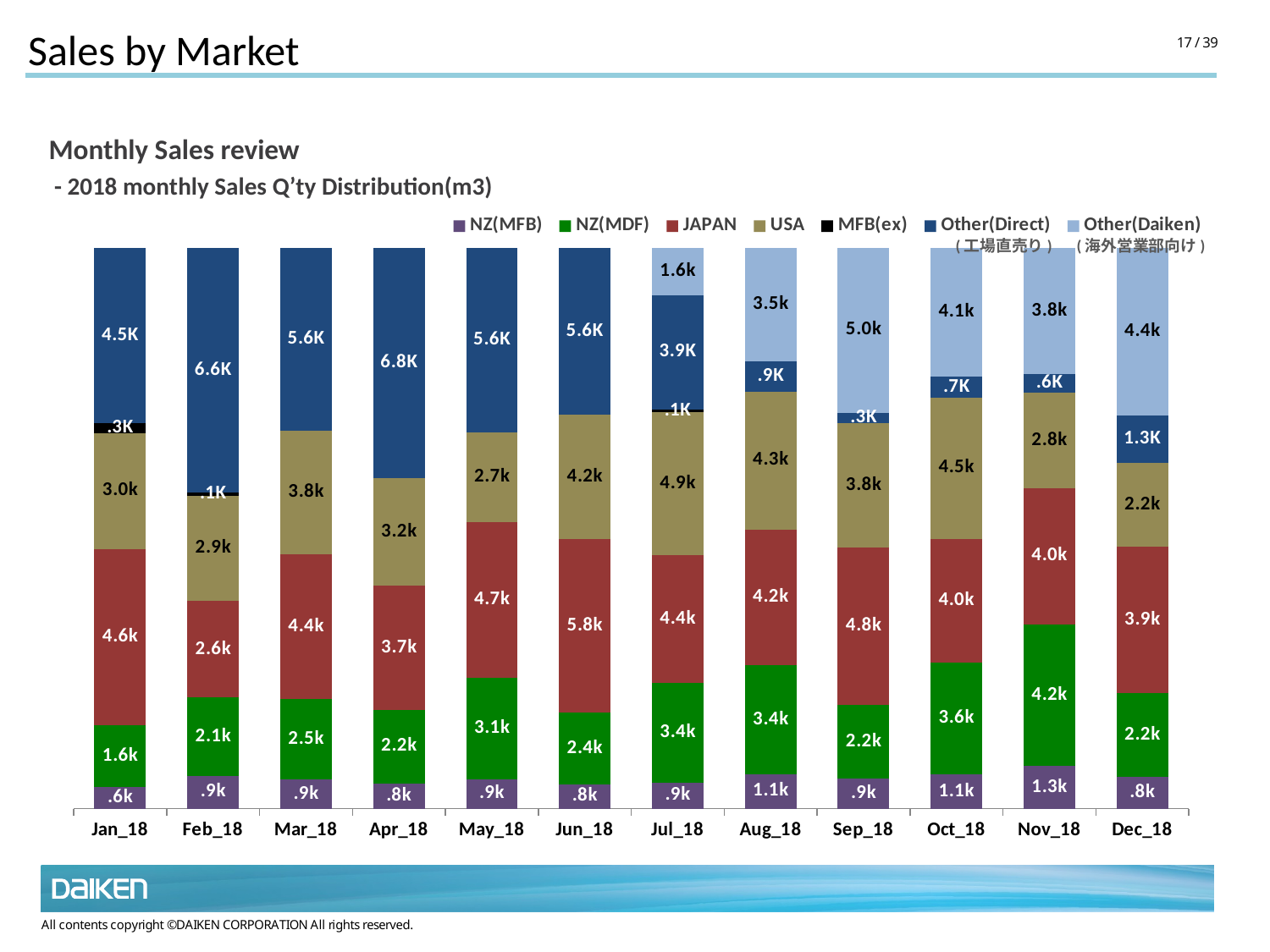
What is the Other(Direct) value for Apr_18? 6.8K Which month has the lowest NZ(MFB) value? Jan_18 What kind of chart is shown on the slide? Stacked bar chart Which is larger, the USA value for Jul_18 or the USA value for Aug_18? Jul_18 What is the Other(Daiken) value for Sep_18? 5.0k What is the USA value for Oct_18? 4.5k What is the JAPAN value for Jun_18? 5.8k How many series does the legend list? 7 Which month has the highest NZ(MFB) value? Nov_18 How many months are shown on the x axis? 12 Which month has the highest NZ(MDF) value? Nov_18 What is the difference between the JAPAN value for Jun_18 and the JAPAN value for Feb_18? 3.2k